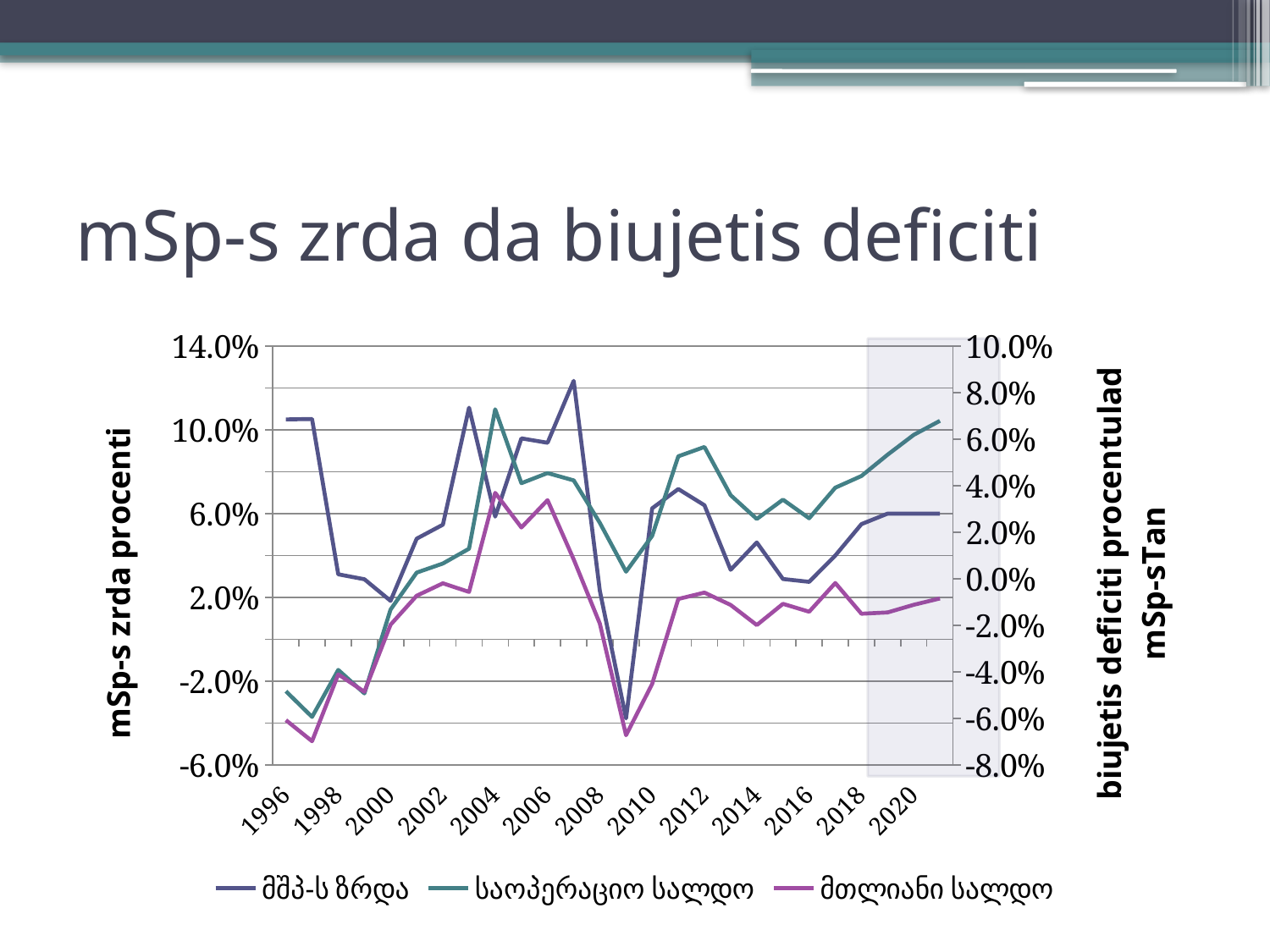
What is the title of the chart? mSp-s zrda da biujetis deficiti What is the label of the left vertical axis? mSp-s zrda procenti What kind of chart is shown on the slide? line chart Does საოპერაციო სალდო rise or fall between 2016 and 2020? rise How many series does the legend list? 3 Is the value of მთლიანი სალდო in 2020 greater or less than 0.0% on the right axis? less Is the value of მთლიანი სალდო in 2009 greater or less than -4.0% on the right axis? less Is the value of მშპ-ს ზრდა in 2007 greater or less than 10.0% on the left axis? greater In which year does მშპ-ს ზრდა reach its lowest value? 2009 In which year does მშპ-ს ზრდა reach its highest value? 2007